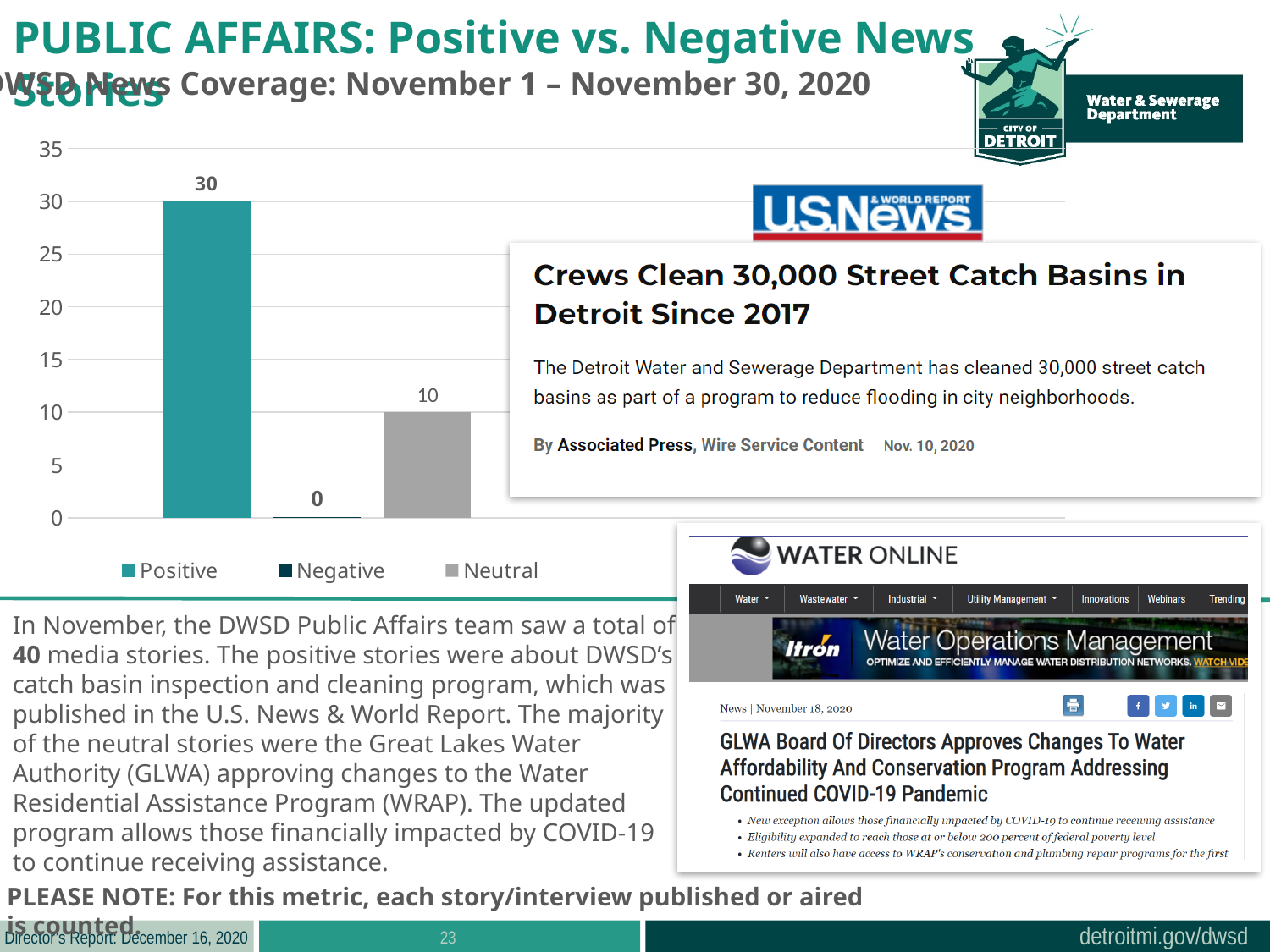
What is the value for Neutral news stories? 10 Is the value for Positive greater or less than 25? greater What is the total of the Positive, Negative and Neutral values? 40 Which category has the highest value? Positive What is the value for Positive news stories? 30 What kind of chart is shown on the slide? Bar chart What is the highest value shown on the vertical axis? 35 How many series does the legend list? 3 What is the difference between the Positive and Neutral values? 20 What is the value for Negative news stories? 0 Which is larger, the Neutral value or the Negative value? Neutral Which category has the lowest value? Negative